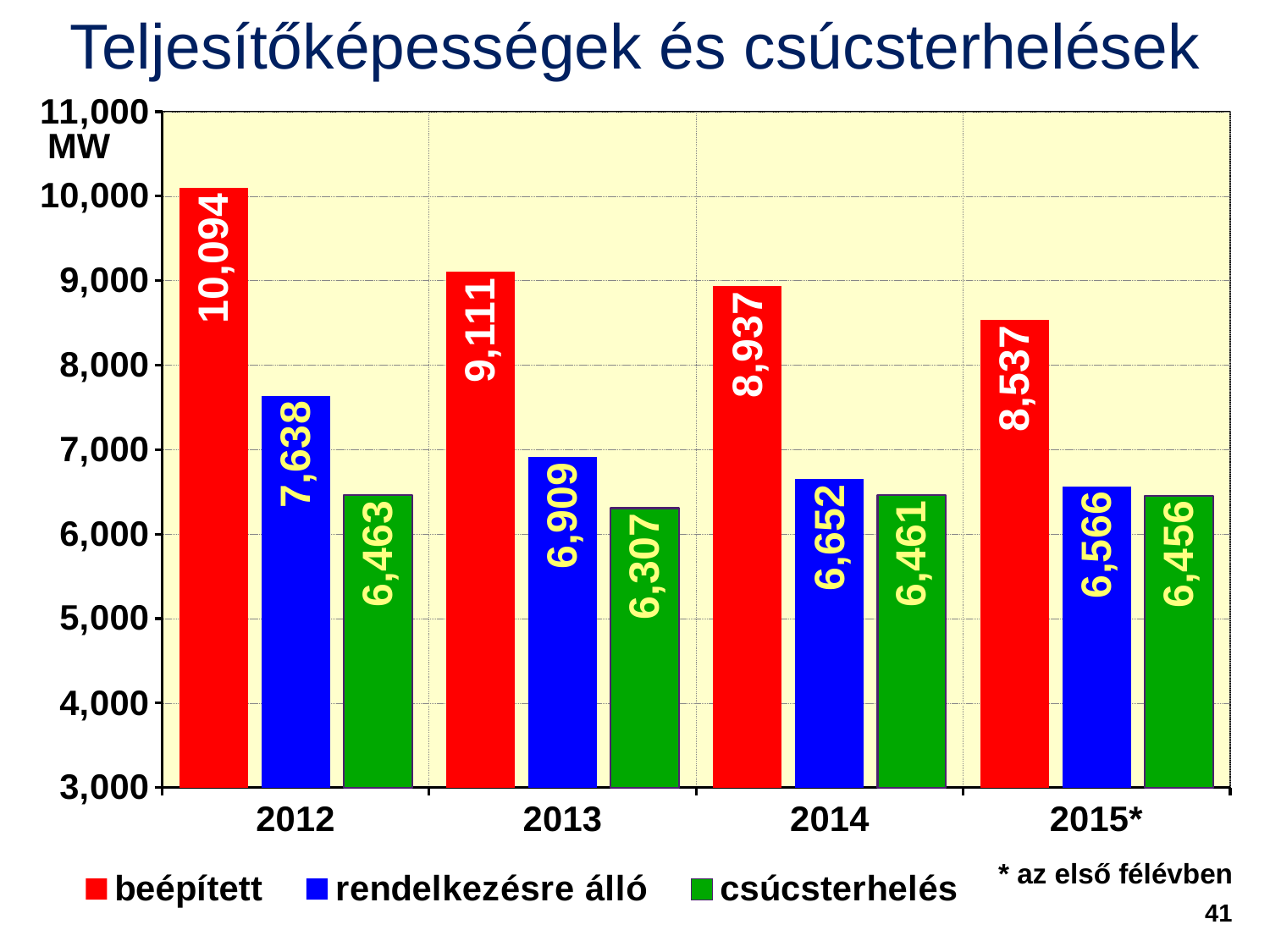
What kind of chart is shown? bar chart What is the value for rendelkezésre álló in 2014? 6,652 How many years are shown on the x axis? 4 Does the beépített value rise or fall from 2012 to 2015*? fall What is the value for csúcsterhelés in 2015*? 6,456 What is the value for beépített in 2012? 10,094 How many series does the legend list? 3 What is the difference between beépített and rendelkezésre álló in 2013? 2,202 In which year is the beépített value highest? 2012 Is the value for beépített in 2015* greater or less than 9,000? less In which year is the csúcsterhelés value lowest? 2013 Which is larger in 2014: rendelkezésre álló or csúcsterhelés? rendelkezésre álló